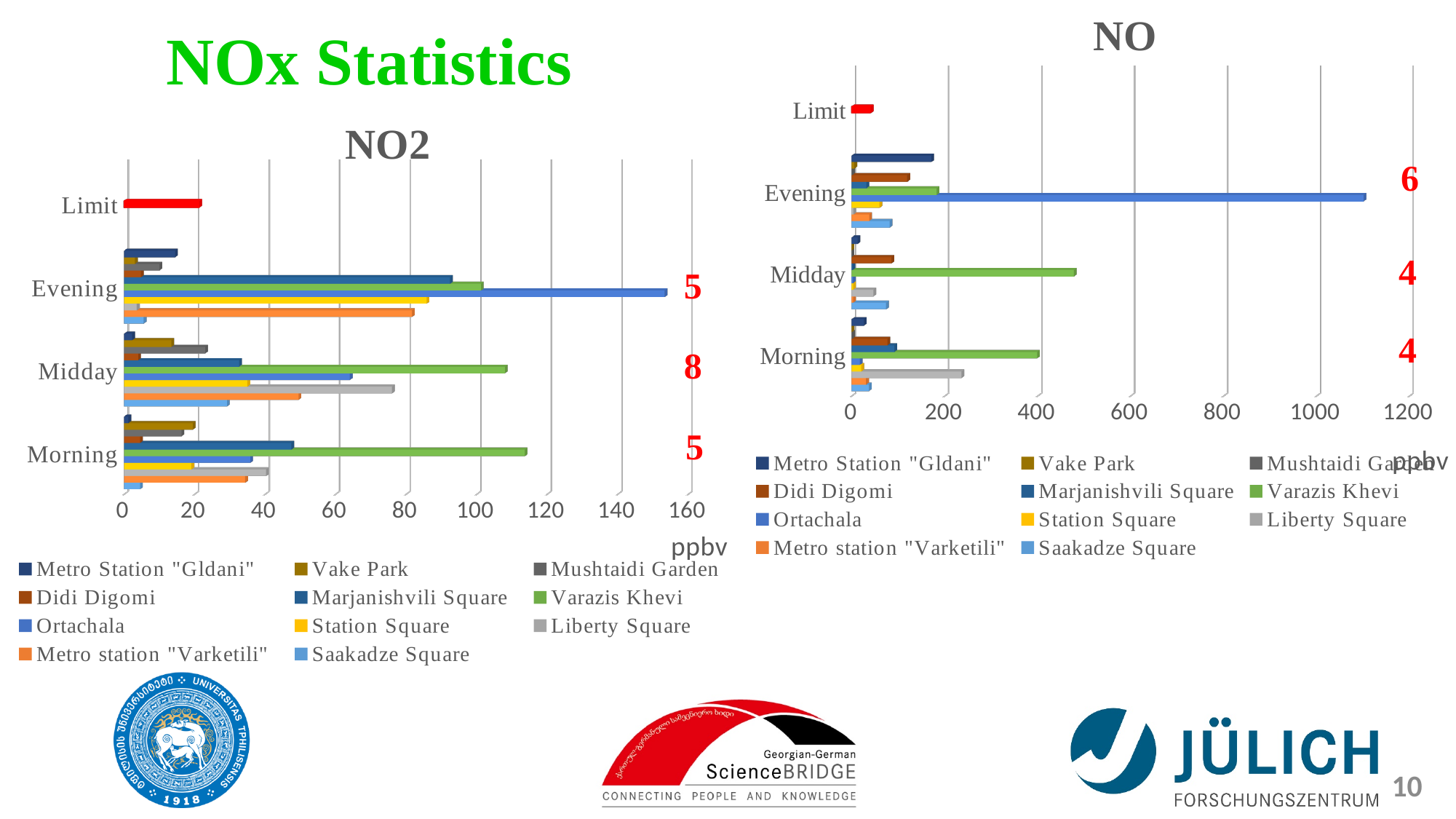
In the NO chart, which series has the longest bar in the Midday category? Varazis Khevi How many series does the legend of the NO chart on the right list? 11 In the NO2 chart, is the Evening value for Ortachala greater or less than 140? greater In the NO2 chart, is the Limit value greater or less than 40? less In the NO2 chart, is the Morning value for Varazis Khevi greater or less than 100? greater How many categories are shown on the vertical axis of the NO2 chart? 4 In the NO2 chart, which is larger in the Midday category: Varazis Khevi or Marjanishvili Square? Varazis Khevi What kind of chart is the NO2 chart on the left? bar chart What unit is shown on the horizontal axis of the NO2 chart? ppbv In the NO chart, which series has the longest bar in the Evening category? Ortachala